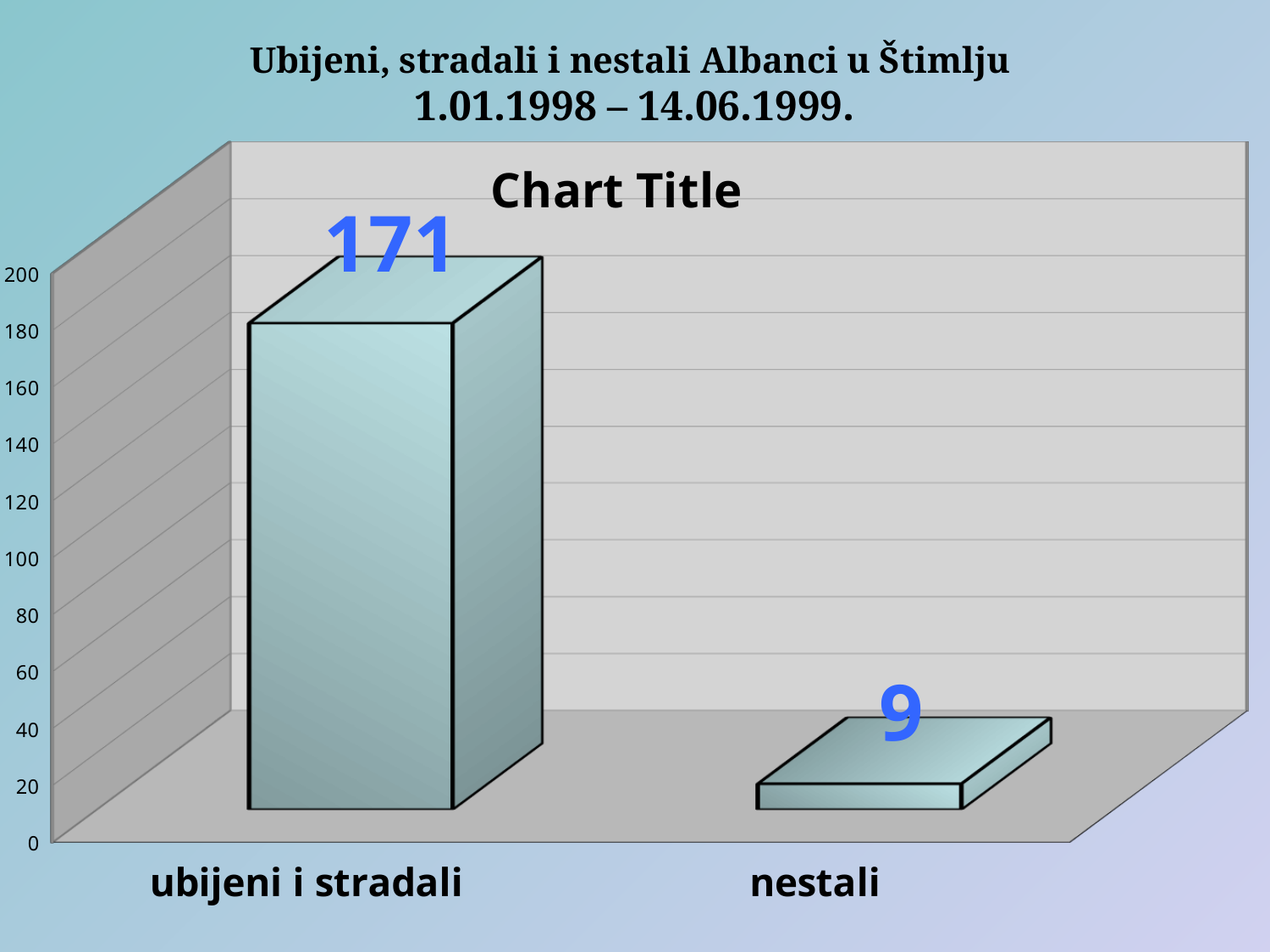
Is the value for "ubijeni i stradali" greater or less than 160? greater Which category has the highest value? ubijeni i stradali What is the value for "ubijeni i stradali"? 171 What is the value for "nestali"? 9 Is the value for "nestali" greater or less than 20? less What kind of chart is shown on the slide? bar chart What is the difference between the values for "ubijeni i stradali" and "nestali"? 162 Which is larger, the value for "ubijeni i stradali" or the value for "nestali"? ubijeni i stradali What is the highest value shown on the vertical axis? 200 What is the total of the two values shown on the chart? 180 How many categories are shown on the chart? 2 Which category has the lowest value? nestali